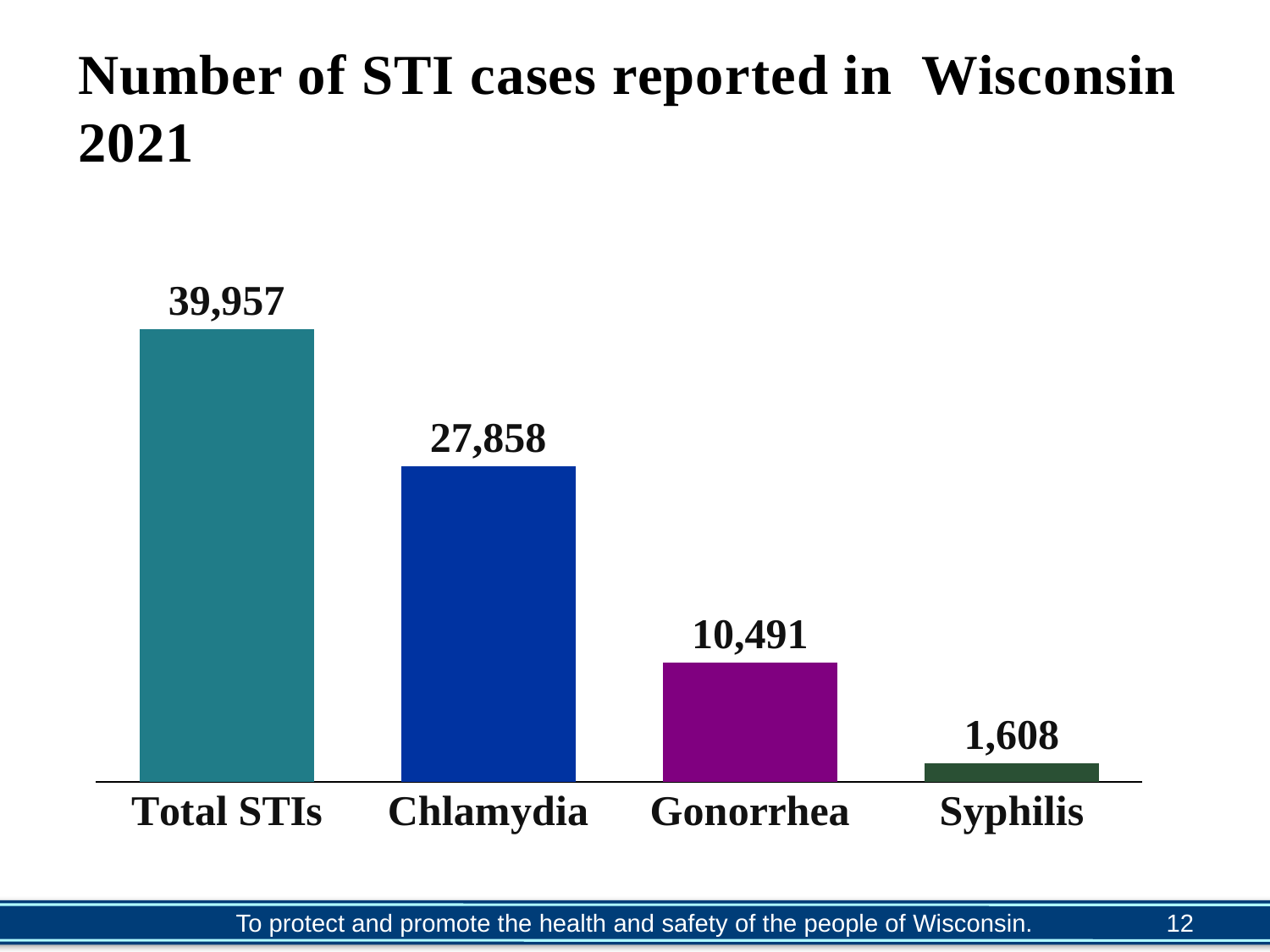
What is the difference between the Chlamydia and Gonorrhea case counts? 17,367 Which of the three individual STIs (Chlamydia, Gonorrhea, Syphilis) has the highest number of cases? Chlamydia How many STI cases in total were reported in Wisconsin in 2021 according to the chart? 39,957 Which is larger, the number of Gonorrhea cases or the number of Syphilis cases? Gonorrhea Which category has the lowest value on the chart? Syphilis What colour is the bar for Gonorrhea? Purple How many more cases of Gonorrhea than Syphilis were reported? 8,883 How many Chlamydia cases does the chart show? 27,858 What type of chart is shown on the slide? Bar chart How many Syphilis cases are shown on the chart? 1,608 What is the value shown for Gonorrhea? 10,491 How many bars are shown on the chart? 4